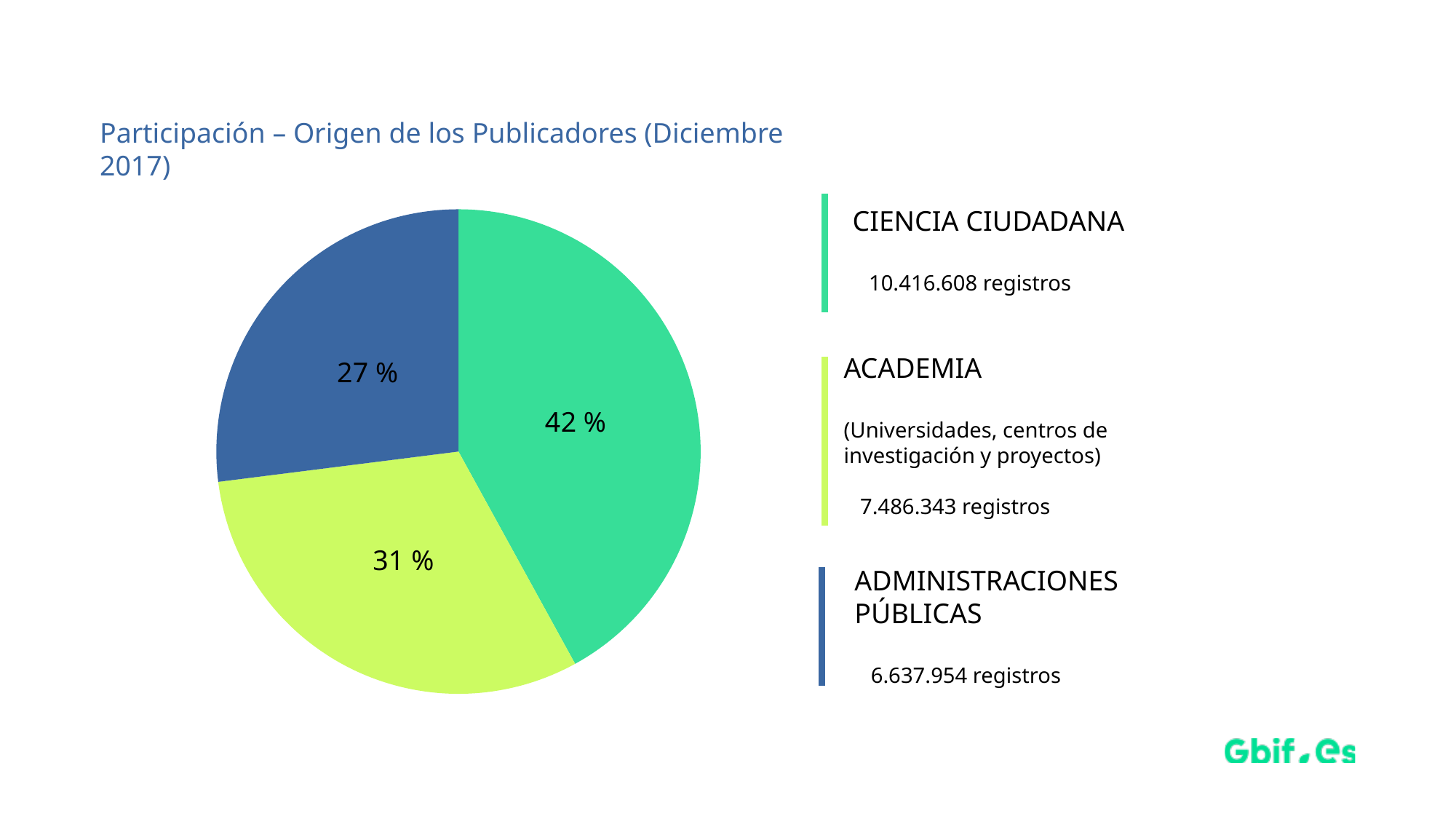
What colour is the ACADEMIA slice of the pie? Yellow-green How many registros are listed for ADMINISTRACIONES PÚBLICAS? 6.637.954 registros How many registros are listed for CIENCIA CIUDADANA? 10.416.608 registros What share of the pie does ADMINISTRACIONES PÚBLICAS represent? 27 % How many slices does the pie chart have? 3 Which category has the smallest slice of the pie? ADMINISTRACIONES PÚBLICAS What share of the pie does CIENCIA CIUDADANA represent? 42 % Which slice is larger, ACADEMIA or ADMINISTRACIONES PÚBLICAS? ACADEMIA What share of the pie does ACADEMIA represent? 31 % What kind of chart is shown on the slide? Pie chart Which category has the largest slice of the pie? CIENCIA CIUDADANA What is the difference in percentage points between the CIENCIA CIUDADANA slice and the ADMINISTRACIONES PÚBLICAS slice? 15 %